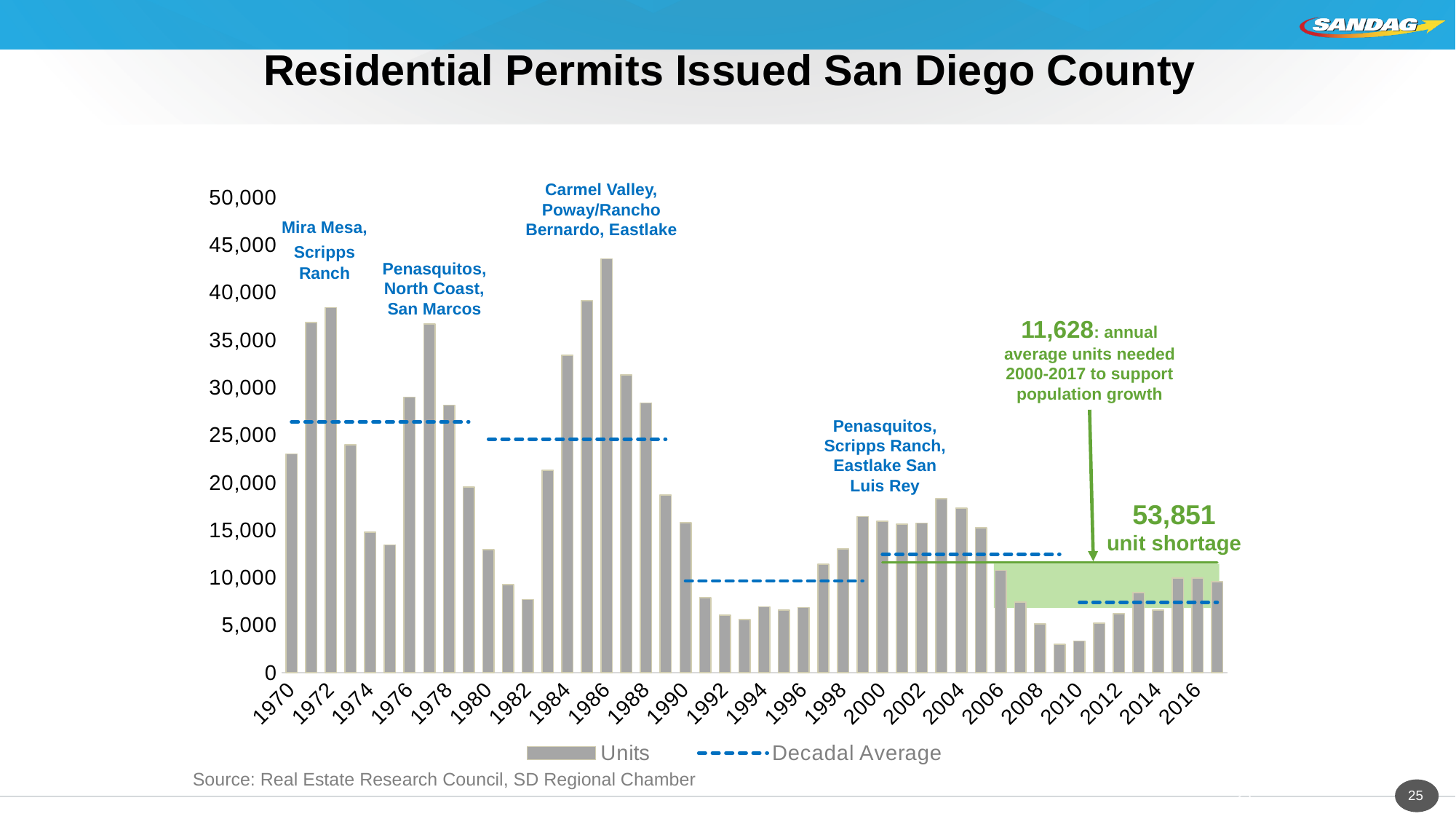
Is the value for 1993 greater or less than 10,000? less Is the value for 1986 greater or less than 40,000? greater Is the value for 1970 greater or less than 20,000? greater How many series does the legend list? 2 Do the values rise or fall from 1986 to 1993? fall What kind of chart is shown on the slide? Bar chart Which year has the larger value, 1972 or 1986? 1986 Which year has the highest number of residential permits issued? 1986 According to the annotation, what is the annual average number of units needed 2000-2017 to support population growth? 11,628 What unit shortage does the chart annotation state? 53,851